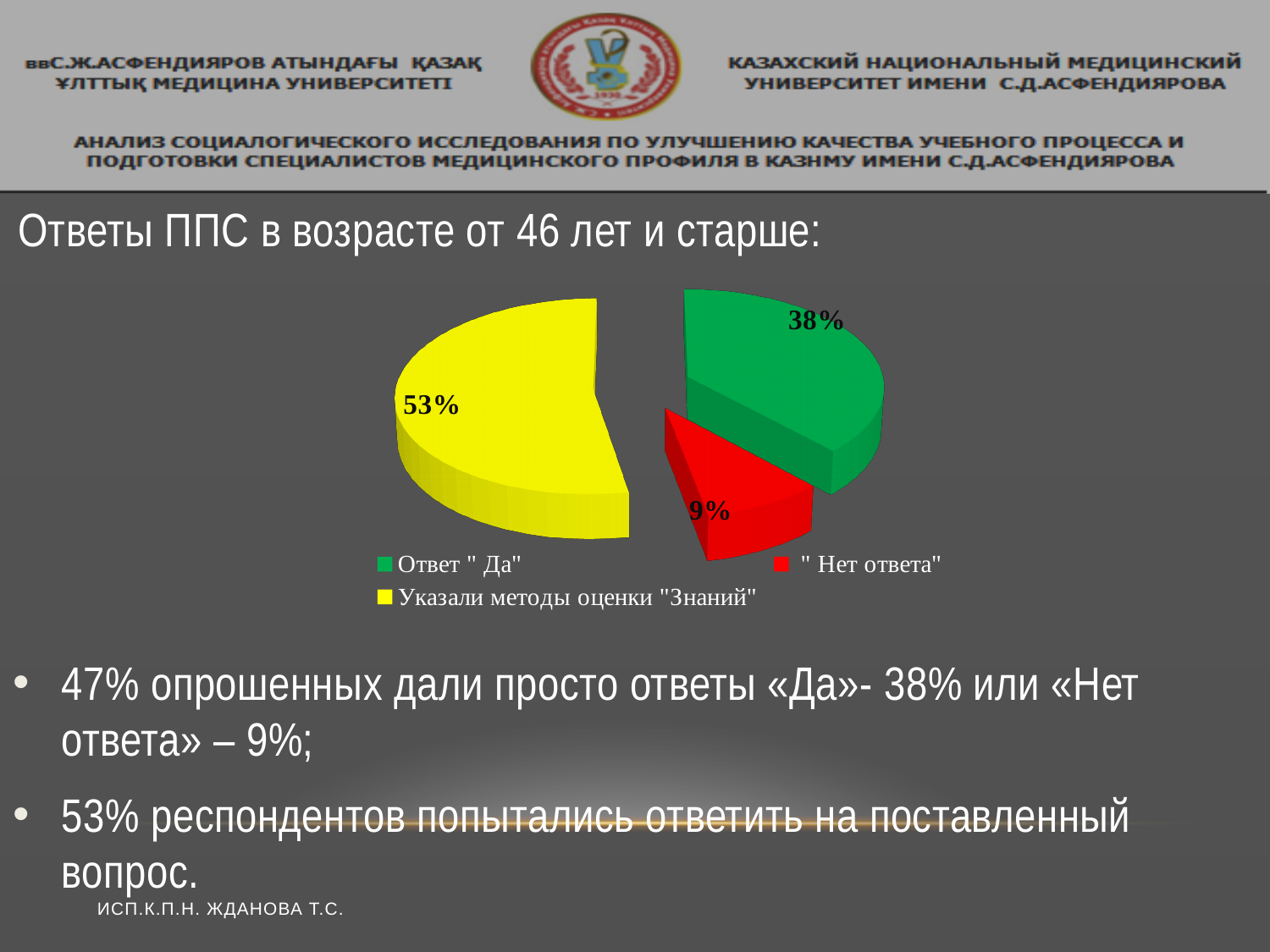
What colour is the slice for "Ответ "Да"" in the pie chart? green Which is larger: the "Ответ "Да"" slice or the "Указали методы оценки "Знаний"" slice? Указали методы оценки "Знаний" Which slice of the pie chart is the largest? Указали методы оценки "Знаний" What share of the pie is labelled for the slice "Нет ответа"? 9% What is the difference in percentage points between the "Ответ "Да"" slice and the "Нет ответа" slice? 29 How many entries does the legend of the pie chart list? 3 How many slices does the pie chart have? 3 What colour is the slice for "Нет ответа" in the pie chart? red What share of the pie is labelled for the slice "Ответ "Да""? 38% What kind of chart is shown on the slide? pie chart What share of the pie is labelled for the slice "Указали методы оценки "Знаний""? 53% Which slice of the pie chart is the smallest? "Нет ответа"